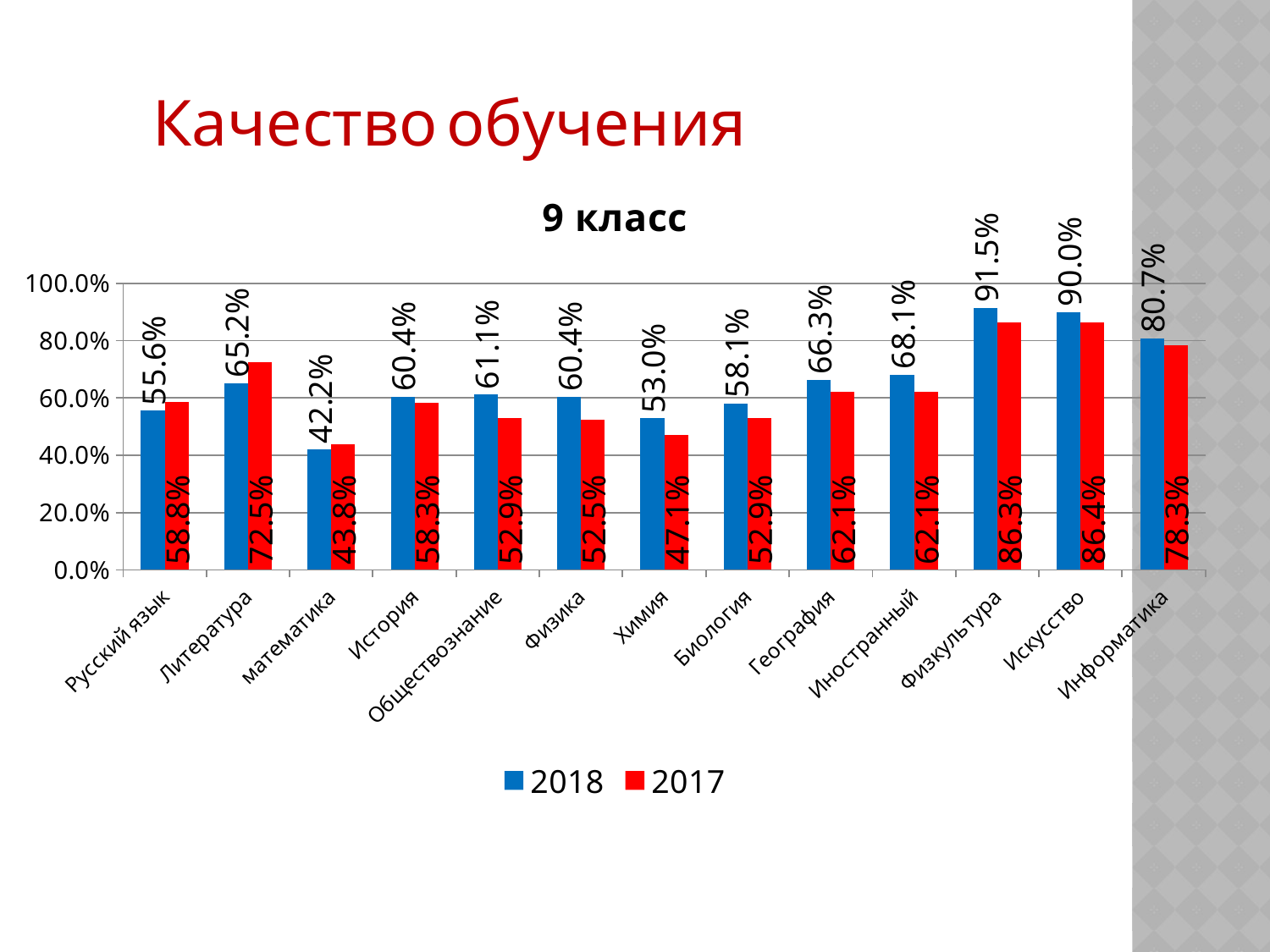
What is the 2018 value for Информатика? 80.7% Which subject has the highest 2018 value? Физкультура Is the 2018 value for математика greater or less than 60.0%? less What is the 2017 value for Литература? 72.5% What is the 2018 value for Физкультура? 91.5% Which is larger for Литература: the 2018 value or the 2017 value? 2017 What is the difference between the 2018 and 2017 values for Химия? 5.9% How many series does the legend list? 2 What kind of chart is shown? bar chart Which subject has the lowest 2017 value? математика How many subjects are shown on the x axis? 13 What is the title of the chart? 9 класс